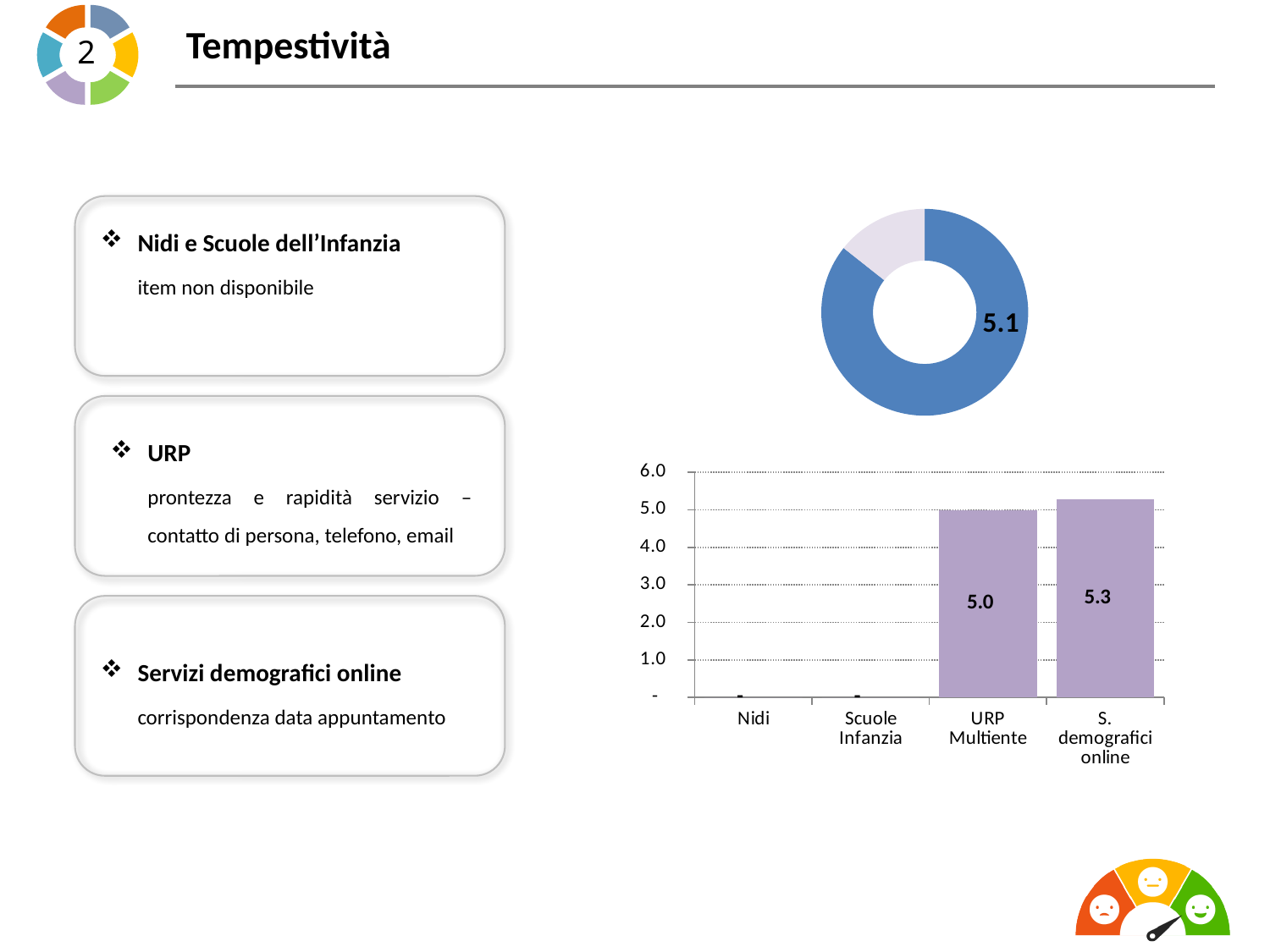
How many categories are shown on the x axis of the bar chart at the bottom right? 4 In the bar chart at the bottom right, what is the value for URP Multiente? 5.0 In the bar chart at the bottom right, what is the difference between the values for S. demografici online and URP Multiente? 0.3 In the bar chart at the bottom right, what is the highest value shown on the y axis? 6.0 What value is printed on the donut chart at the top right of the slide? 5.1 In the bar chart at the bottom right, which category has the highest value? S. demografici online What kind of chart is the chart at the top right of the slide? donut chart What kind of chart is the chart at the bottom right of the slide? bar chart In the bar chart at the bottom right, is the value for S. demografici online greater or less than 4.0? greater In the bar chart at the bottom right, what is the value for S. demografici online? 5.3 In the bar chart at the bottom right, is the value for URP Multiente greater or less than 6.0? less In the bar chart at the bottom right, which is larger: the value for URP Multiente or the value for S. demografici online? S. demografici online